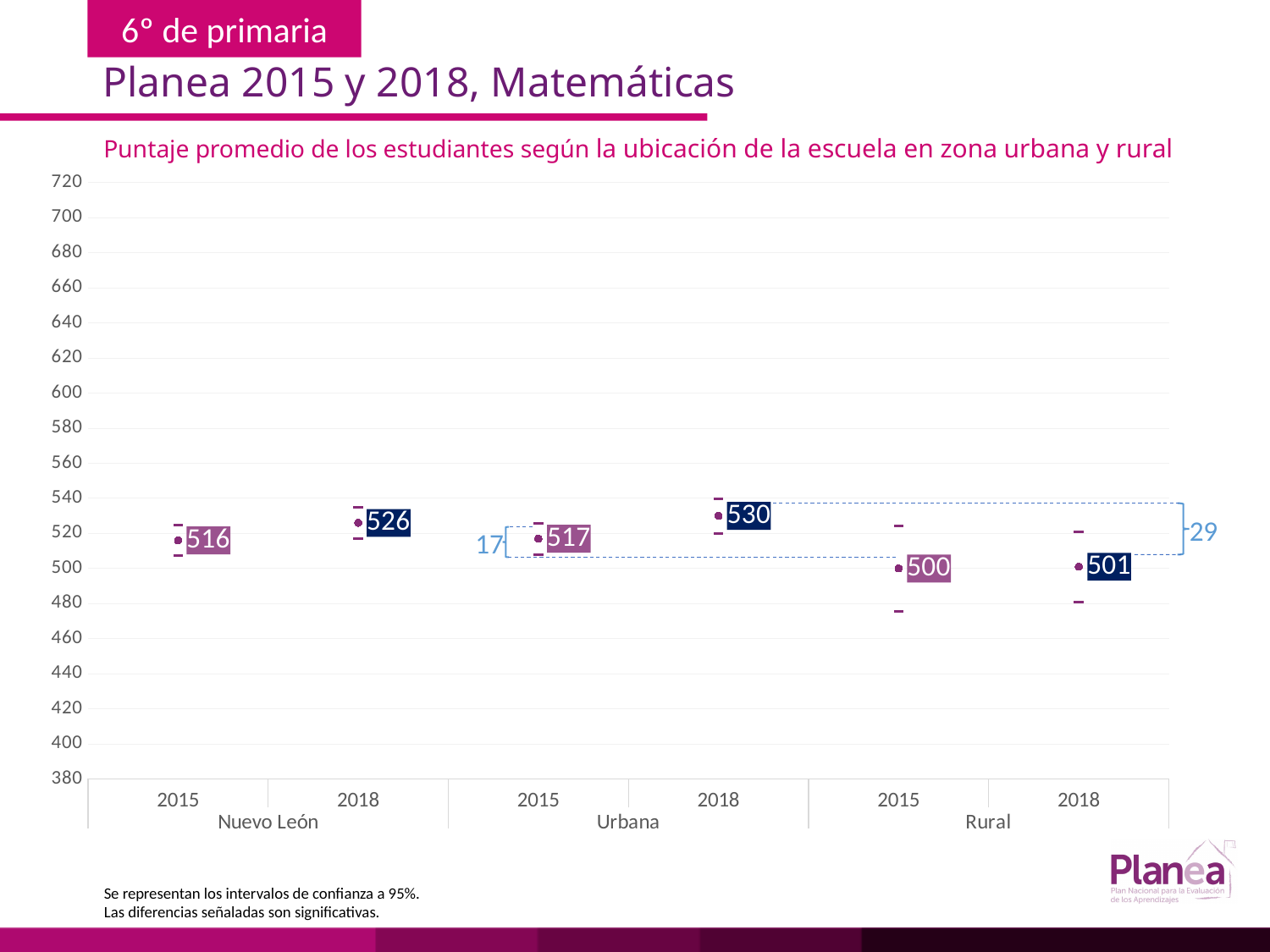
How many data points are plotted on the chart? 6 What is the average score for Nuevo León in 2015? 516 Which is larger, the Urbana score in 2015 or the Nuevo León score in 2015? Urbana 2015 What is the difference between the Urbana and Rural average scores in 2018? 29 Which group and year has the highest average score? Urbana 2018 What is the difference between the Urbana and Rural average scores in 2015? 17 By how many points did the Nuevo León average score change from 2015 to 2018? 10 Did the Rural average score rise or fall from 2015 to 2018? rise What is the average score for Urbana schools in 2018? 530 What is the average score for Nuevo León in 2018? 526 What is the average score for Rural schools in 2015? 500 Which group and year has the lowest average score? Rural 2015